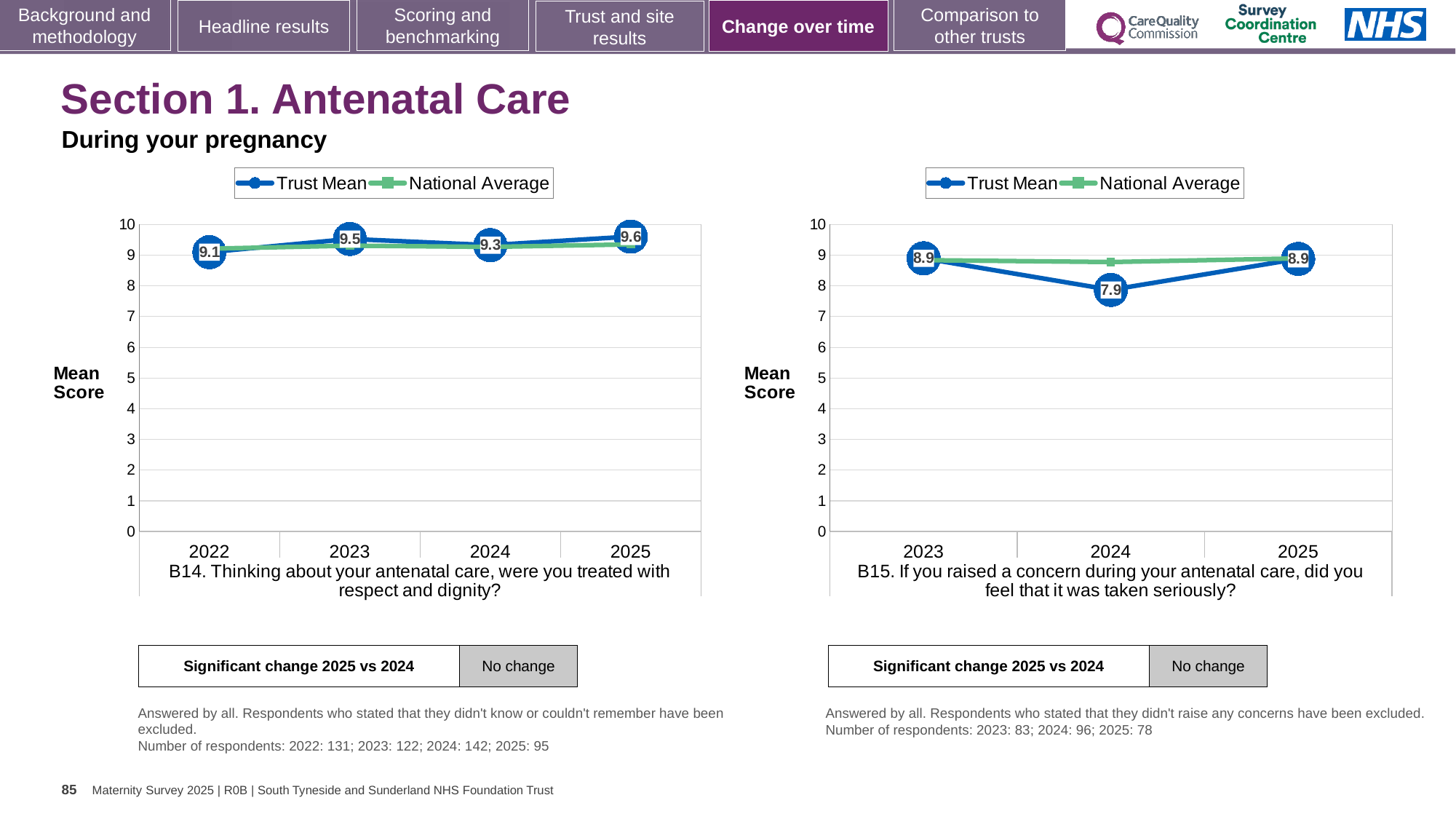
In the B15 chart (right), what is the difference between the Trust Mean scores for 2025 and 2024? 1.0 In the B14 chart (left), what is the Trust Mean score for 2022? 9.1 In the B15 chart (right), which year has the lowest Trust Mean score? 2024 In the B14 chart (left), what is the difference between the Trust Mean scores for 2023 and 2022? 0.4 What kind of chart is the B14 chart (left)? Line chart In the B14 chart (left), what is the Trust Mean score for 2025? 9.6 In the B14 chart (left), is the Trust Mean score higher in 2023 or in 2024? 2023 In the B15 chart (right), is the National Average value for 2024 greater or less than 8? greater In the B15 chart (right), what is the Trust Mean score for 2024? 7.9 How many series does the legend of the B15 chart (right) list? 2 How many years are shown on the x axis of the B14 chart (left)? 4 In the B14 chart (left), which year has the highest Trust Mean score? 2025